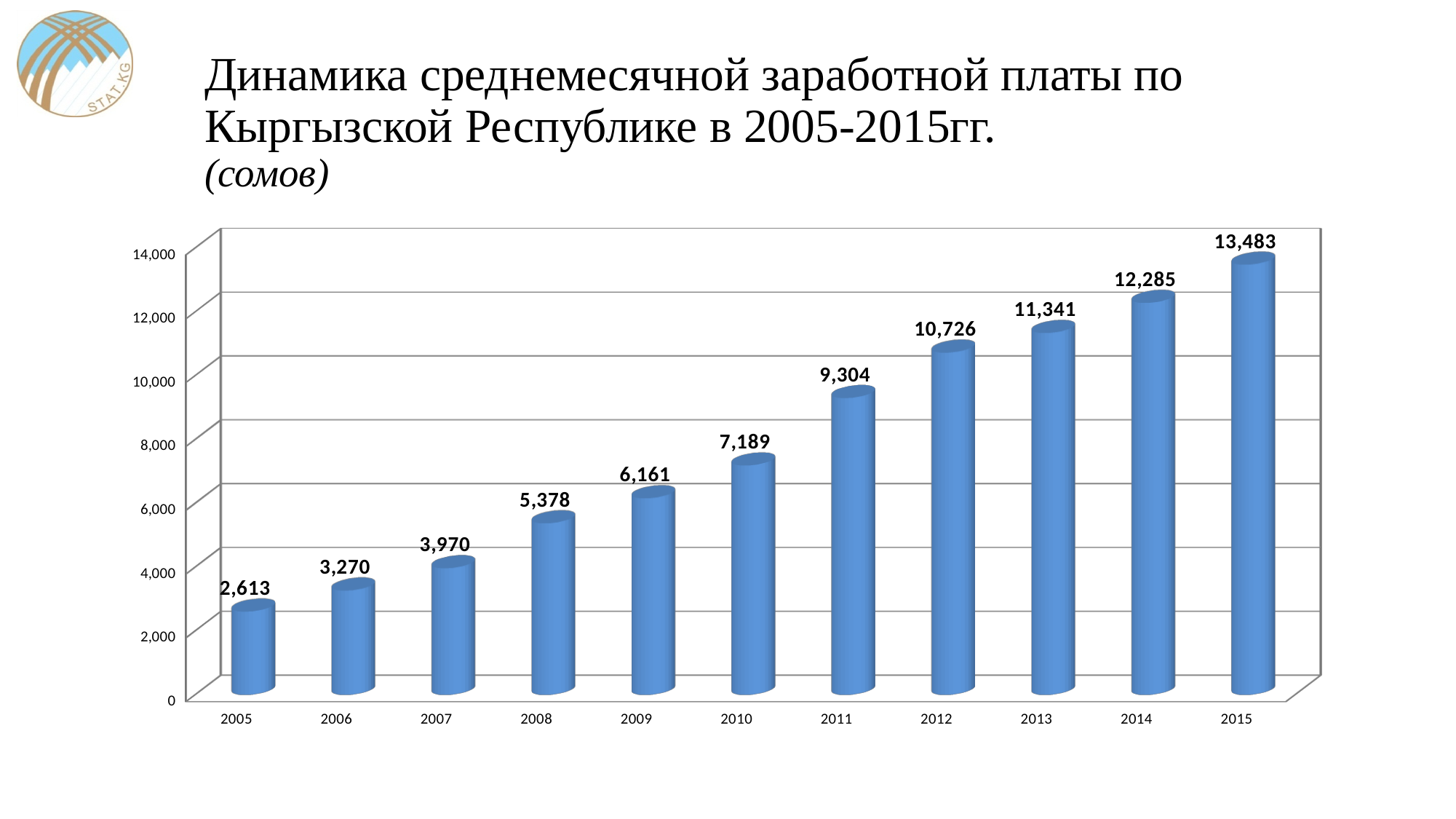
Which year has the highest value? 2015 Do the values rise or fall from 2005 to 2015? rise What value is shown for 2013? 11,341 What value is shown for 2005? 2,613 What is the average monthly wage value shown for 2010? 7,189 Which year has the lowest value? 2005 Which is larger, the value for 2011 or the value for 2012? 2012 How many years are shown on the x axis? 11 What is the difference between the values for 2009 and 2008? 783 What is the difference between the values for 2015 and 2014? 1,198 Is the value for 2007 greater or less than 4,000? less What kind of chart is shown on the slide? bar chart